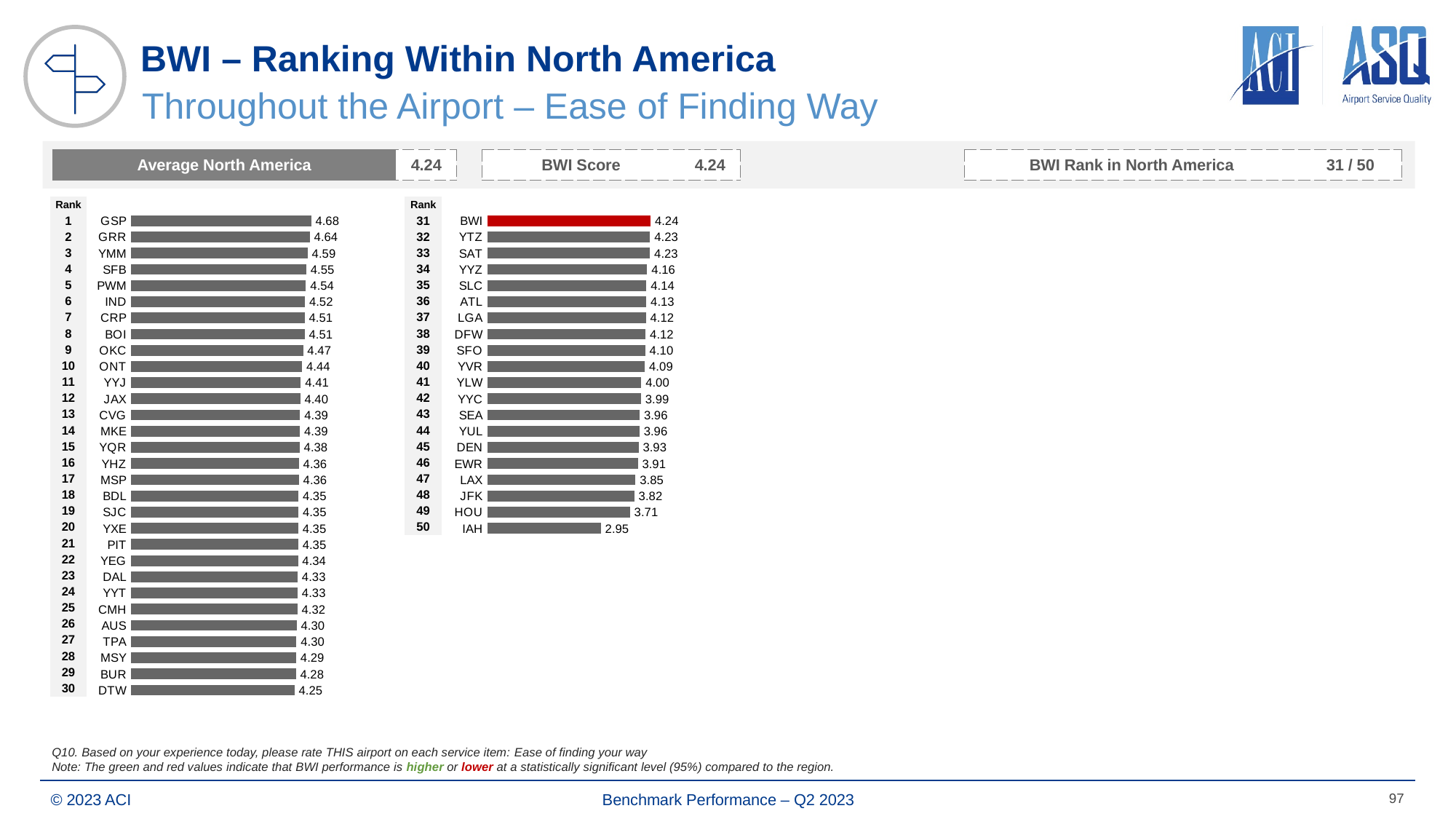
In the right chart (ranks 31–50), which airport has the lowest value? IAH What kind of chart is used to show the airport scores on this slide? Bar chart In the right chart (ranks 31–50), which airport's bar is coloured red? BWI In the right chart (ranks 31–50), which has the larger value, LAX or JFK? LAX How many airports are plotted in the right chart (ranks 31–50)? 20 How many airports are plotted in the left chart (ranks 1–30)? 30 In the right chart (ranks 31–50), what is the value for BWI? 4.24 In the left chart (ranks 1–30), what is the difference between the values for GSP and DTW? 0.43 In the left chart (ranks 1–30), which airport has the highest value? GSP In the right chart (ranks 31–50), what is the value for IAH? 2.95 In the right chart (ranks 31–50), what is the difference between the values for BWI and IAH? 1.29 In the left chart (ranks 1–30), what is the value for GSP? 4.68